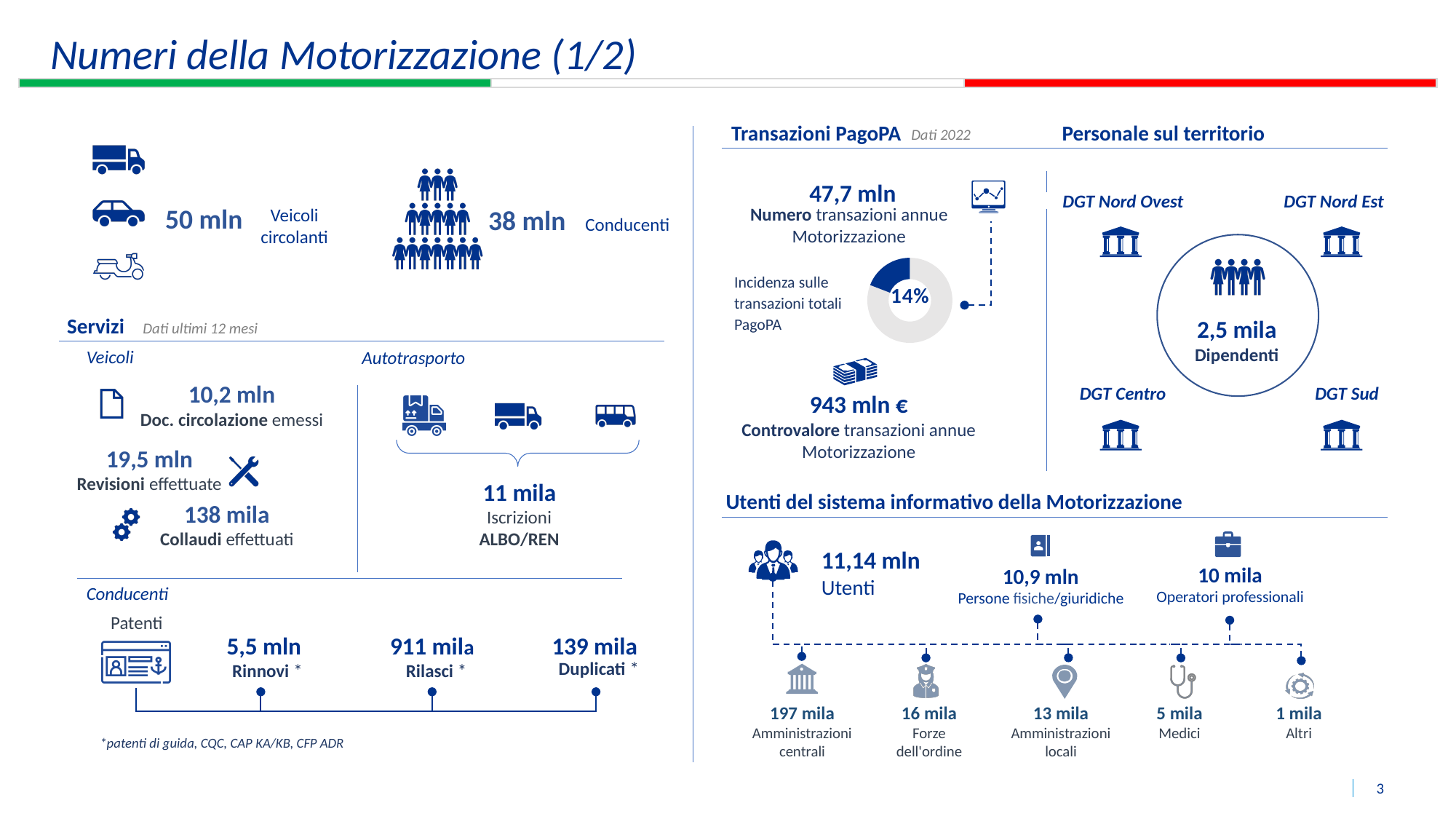
In the donut chart in the 'Transazioni PagoPA' section, is the blue slice larger or smaller than the grey slice? smaller How many slices does the donut chart in the 'Transazioni PagoPA' section have? 2 In the donut chart in the 'Transazioni PagoPA' section, what share of total PagoPA transactions is attributed to the Motorizzazione? 14% What kind of chart is shown in the 'Transazioni PagoPA' section of the slide? pie chart (donut) What does the highlighted blue slice of the donut chart in the 'Transazioni PagoPA' section represent? Incidenza sulle transazioni totali PagoPA What year do the data in the 'Transazioni PagoPA' section, including the donut chart, refer to? 2022